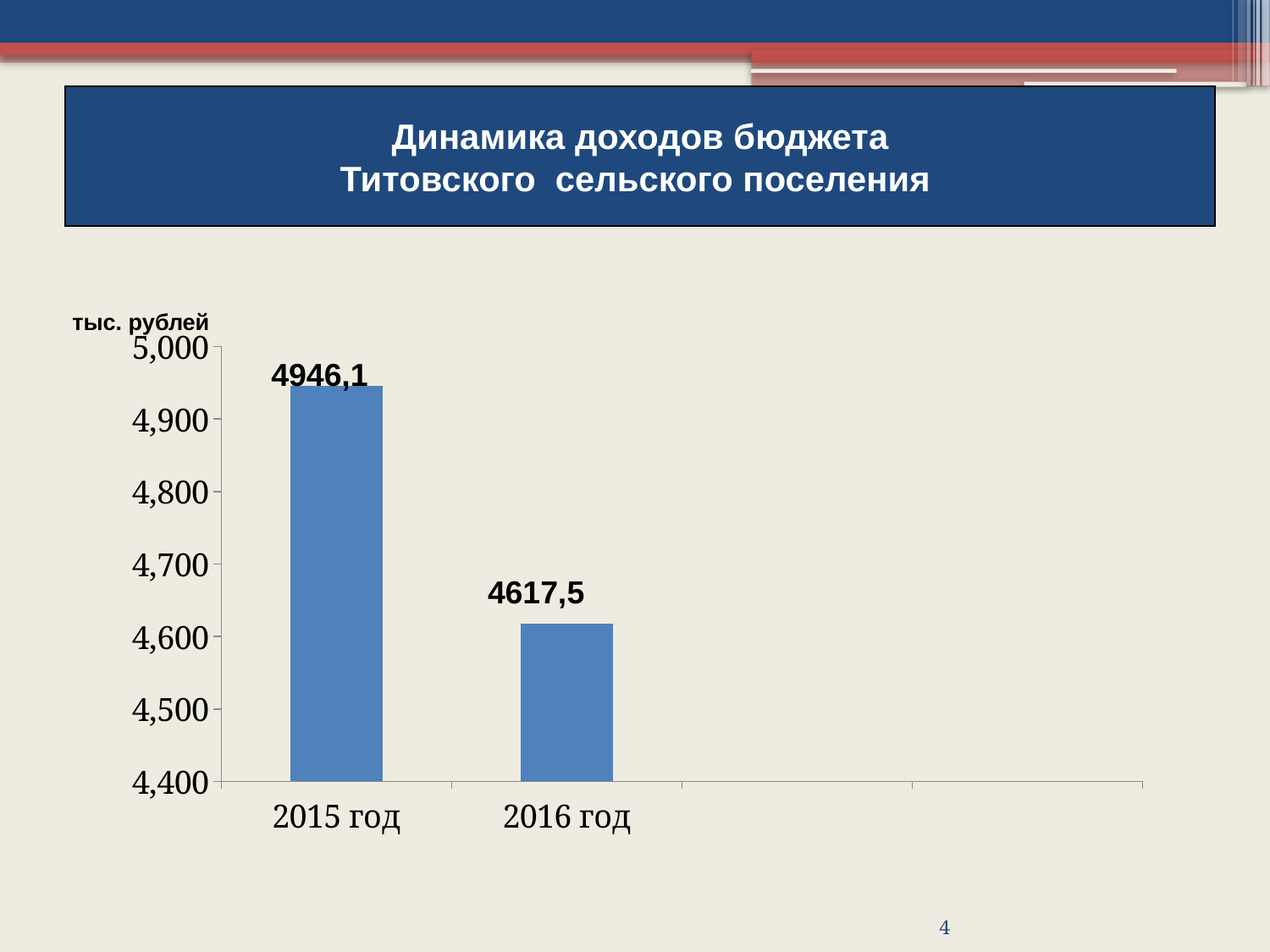
Is the value for 2015 год greater or less than 4,900? greater What is the value for 2015 год? 4946,1 Which is larger, the value for 2015 год or the value for 2016 год? 2015 год Do the values rise or fall from 2015 год to 2016 год? fall What is the difference between the values for 2015 год and 2016 год? 328,6 Which year has the highest value? 2015 год What kind of chart is shown on the slide? bar chart What unit is shown above the vertical axis of the chart? тыс. рублей What is the value for 2016 год? 4617,5 Which year has the lowest value? 2016 год How many bars are shown in the chart? 2 Is the value for 2016 год greater or less than 4,700? less